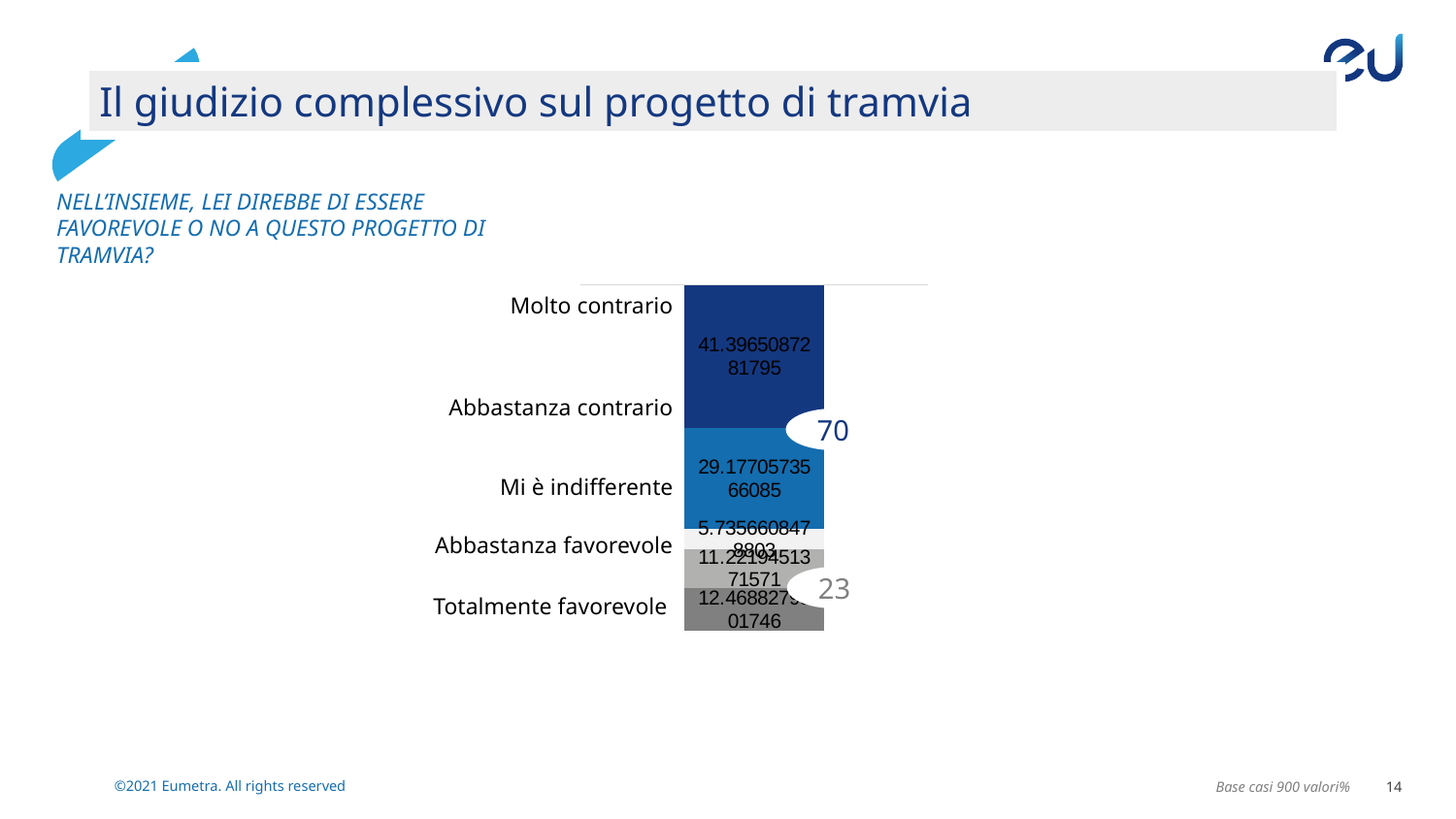
What is the difference between the Molto contrario value and the Abbastanza contrario value? 12.219451371571 What number is shown in the callout next to the contrario segments of the bar? 70 Which is larger, the value for Molto contrario or the value for Abbastanza contrario? Molto contrario What kind of chart is shown on the slide? bar chart What number is shown in the callout next to the favorevole segments of the bar? 23 Which category has the largest segment in the stacked bar? Molto contrario What value is printed on the Abbastanza contrario segment? 29.1770573566085 How many categories are listed on the chart? 5 Which is larger, the value for Molto contrario or the value for Mi è indifferente? Molto contrario What value is printed on the Molto contrario segment? 41.3965087281795 Which category has the smallest segment in the stacked bar? Mi è indifferente